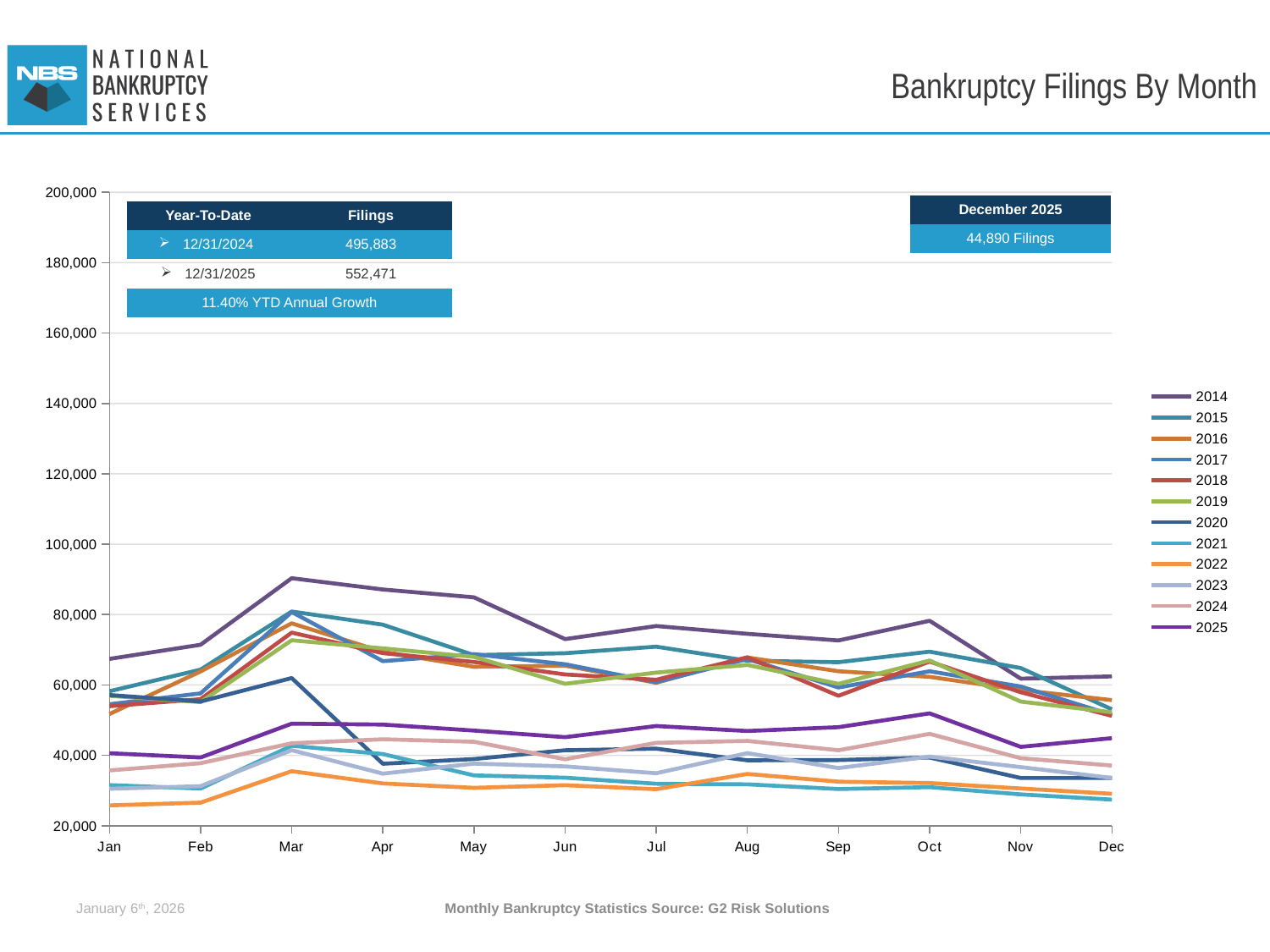
Which year has the highest value in Mar? 2014 According to the callout on the chart, how many filings were there in December 2025? 44,890 Filings Is the value for 2022 in Jan greater or less than 40,000? less Is the value for 2014 in Mar greater or less than 80,000? greater How many months are shown along the x axis? 12 What is the title of the chart? Bankruptcy Filings By Month What is the difference between the year-to-date filings for 12/31/2025 and 12/31/2024? 56,588 How many series does the legend list? 12 What kind of chart is shown on the slide? line chart What is the year-to-date filings figure shown for 12/31/2025? 552,471 Which year has the lowest value in Jan? 2022 What is the year-to-date filings figure shown for 12/31/2024? 495,883